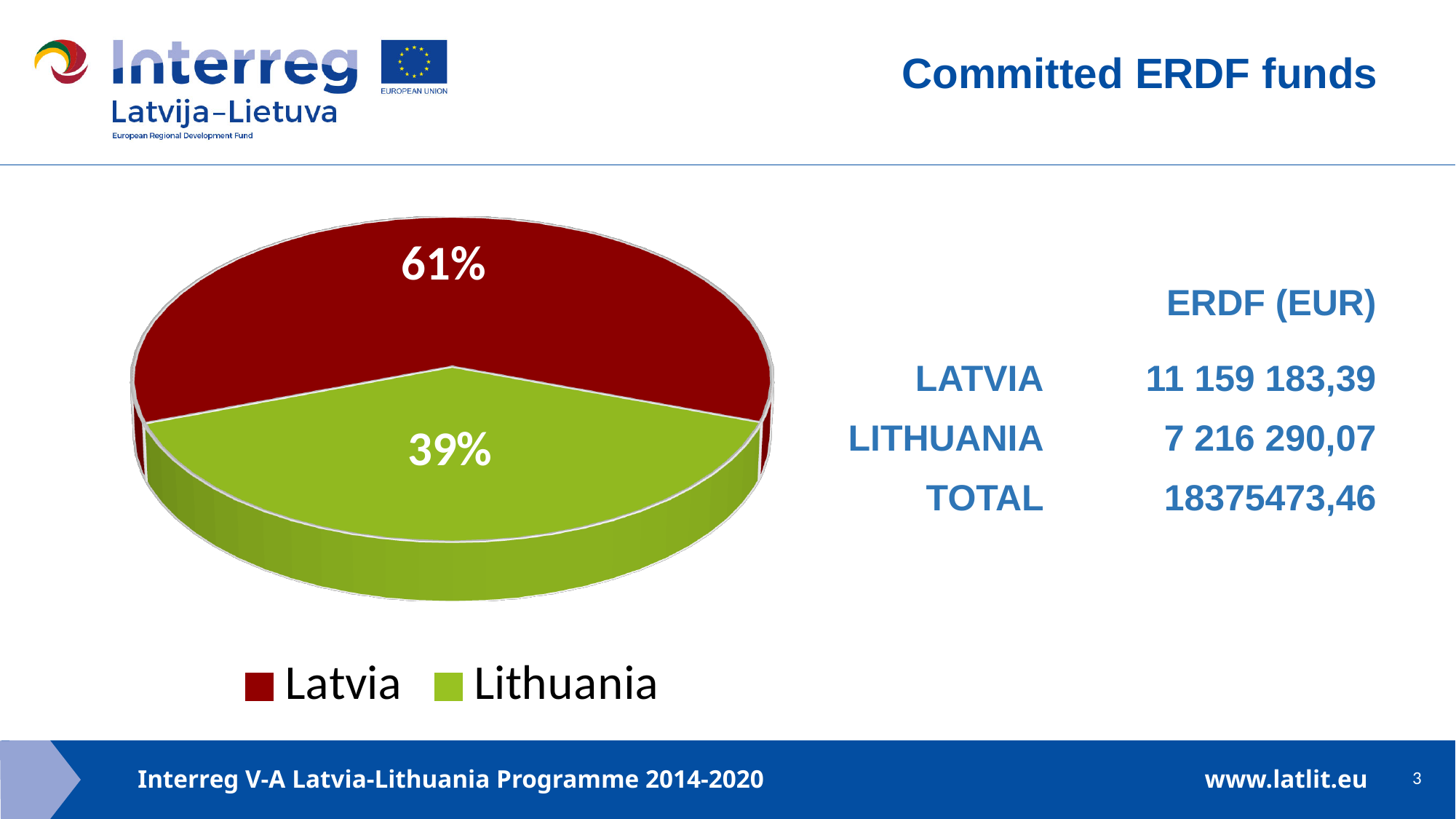
What colour represents Lithuania in the pie chart? Green Which slice of the pie is the smallest? Lithuania How many entries does the legend list? 2 Which has the larger share of the pie, Latvia or Lithuania? Latvia What share of the pie does Lithuania account for? 39% What is the difference in percentage points between Latvia's and Lithuania's shares? 22 percentage points How many slices does the pie chart have? 2 Which slice of the pie is the largest? Latvia What kind of chart is shown on the slide? Pie chart What share of the pie does Latvia account for? 61% Is Latvia's share of the pie greater or less than 50%? greater What colour represents Latvia in the pie chart? Dark red